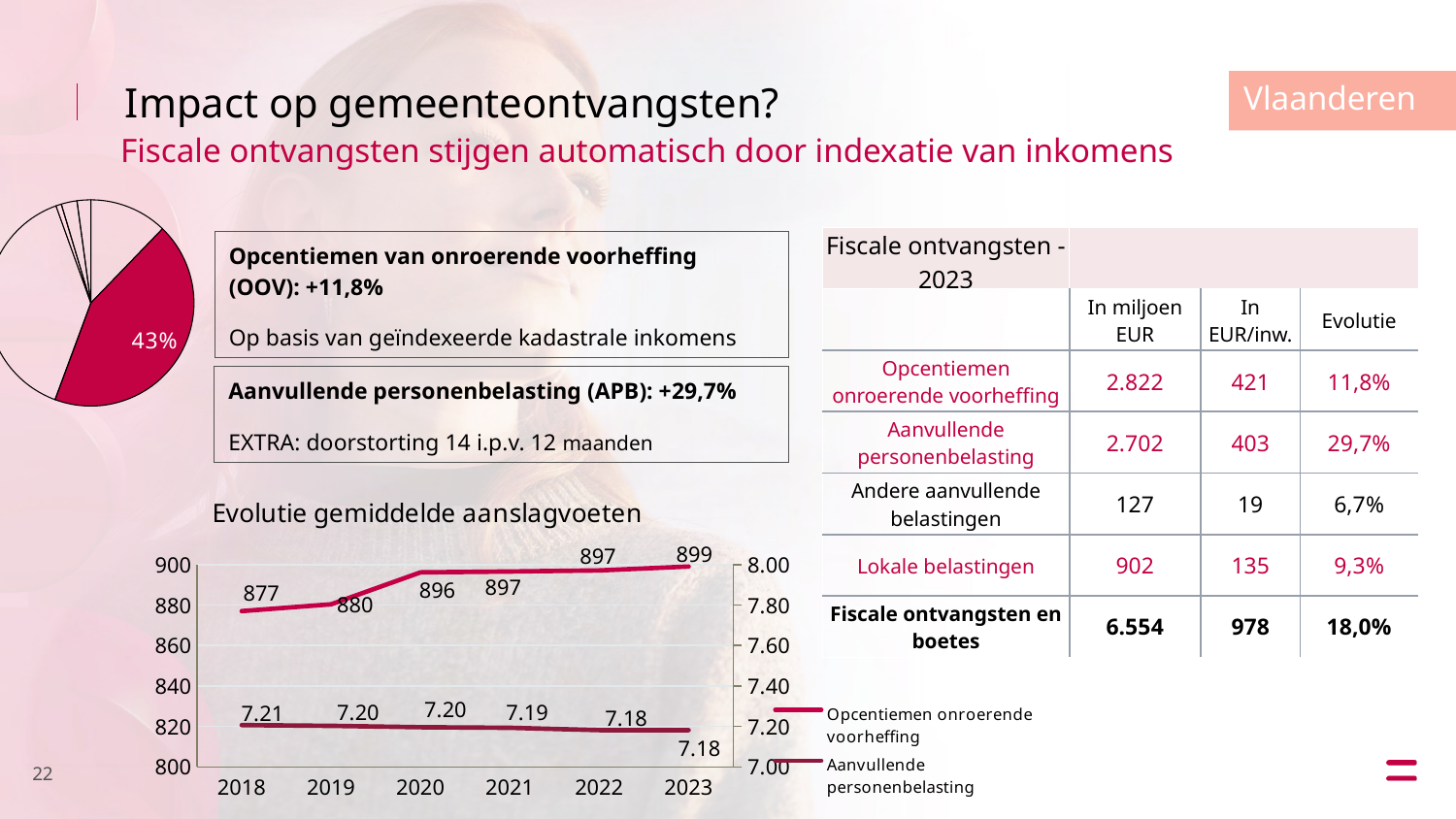
In the 'Evolutie gemiddelde aanslagvoeten' chart, what is the difference between the Opcentiemen onroerende voorheffing values for 2023 and 2018? 22 In the 'Evolutie gemiddelde aanslagvoeten' chart, what is the value for Opcentiemen onroerende voorheffing in 2020? 896 In the 'Evolutie gemiddelde aanslagvoeten' chart, what is the value for Aanvullende personenbelasting in 2018? 7.21 In the 'Evolutie gemiddelde aanslagvoeten' chart, does the Aanvullende personenbelasting series rise or fall from 2018 to 2023? Fall In the 'Evolutie gemiddelde aanslagvoeten' chart, is the Opcentiemen onroerende voorheffing value for 2019 greater or less than 860? greater How many series does the legend of the 'Evolutie gemiddelde aanslagvoeten' chart list? 2 What kind of chart is 'Evolutie gemiddelde aanslagvoeten'? Line chart In the 'Evolutie gemiddelde aanslagvoeten' chart, in which year is Opcentiemen onroerende voorheffing lowest? 2018 What percentage is labelled on the highlighted slice of the pie chart on the left of the slide? 43% In the 'Evolutie gemiddelde aanslagvoeten' chart, in which year is Opcentiemen onroerende voorheffing highest? 2023 In the 'Evolutie gemiddelde aanslagvoeten' chart, how many years are shown on the x axis? 6 In the 'Evolutie gemiddelde aanslagvoeten' chart, what is the value for Opcentiemen onroerende voorheffing in 2023? 899